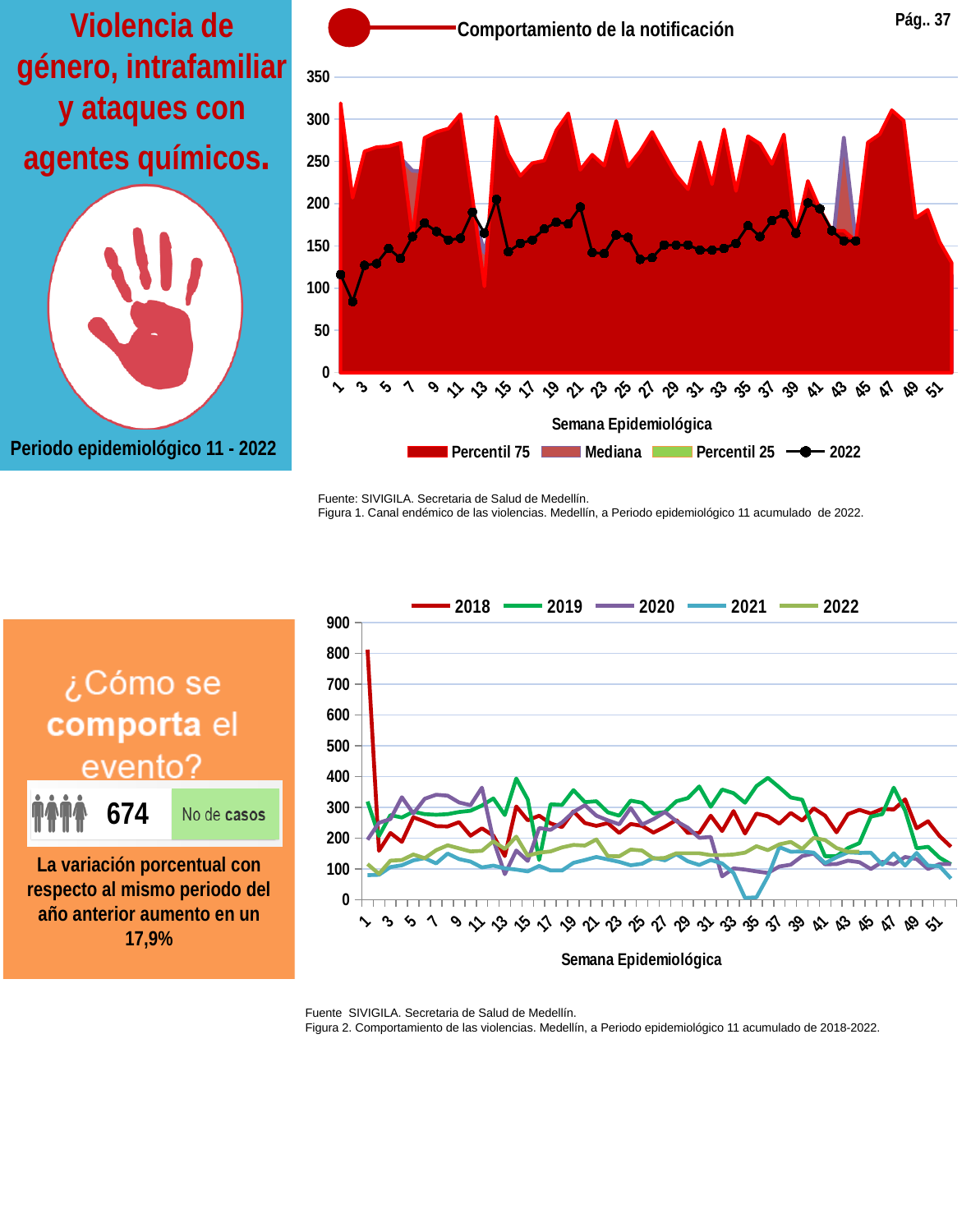
What kind of chart is the bottom chart (Figura 2)? Line chart In the bottom chart (Figura 2), is the 2019 value at week 36 greater or less than 300? greater What is the x-axis label of the chart titled "Comportamiento de la notificación"? Semana Epidemiológica In the chart titled "Comportamiento de la notificación", is the 2022 value at week 2 greater or less than 100? less In the bottom chart (Figura 2), is the 2021 value at week 35 greater or less than 100? less In the bottom chart (Figura 2), how many series does the legend list? 5 In the chart titled "Comportamiento de la notificación", how many series does the legend list? 4 In the chart titled "Comportamiento de la notificación", which series is drawn as a black line with circular markers? 2022 In the bottom chart (Figura 2), which series has the larger value at week 1, 2018 or 2019? 2018 In the bottom chart (Figura 2), does the 2018 line rise or fall from week 1 to week 2? Fall